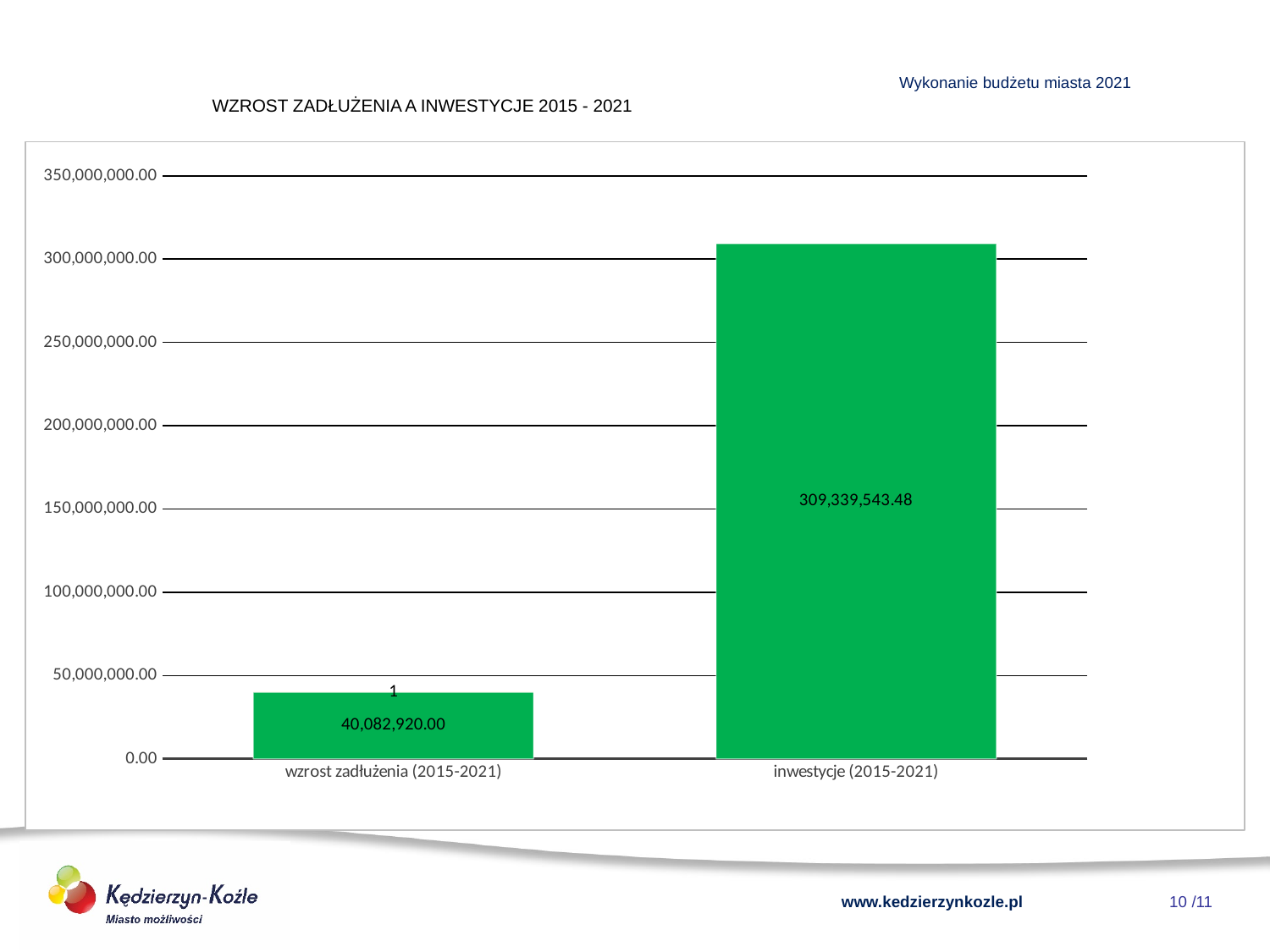
Is the value for inwestycje (2015-2021) greater or less than 300,000,000.00? greater What is the title of the chart? WZROST ZADŁUŻENIA A INWESTYCJE 2015 - 2021 Which category has the highest value? inwestycje (2015-2021) What colour are the bars in the chart? green Which is larger: the value for wzrost zadłużenia (2015-2021) or the value for inwestycje (2015-2021)? inwestycje (2015-2021) What is the difference between the value for inwestycje (2015-2021) and the value for wzrost zadłużenia (2015-2021)? 269,256,623.48 What kind of chart is shown on the slide? bar chart Is the value for wzrost zadłużenia (2015-2021) greater or less than 50,000,000.00? less What is the value for wzrost zadłużenia (2015-2021)? 40,082,920.00 What is the value for inwestycje (2015-2021)? 309,339,543.48 How many categories are shown on the x axis? 2 Which category has the lowest value? wzrost zadłużenia (2015-2021)